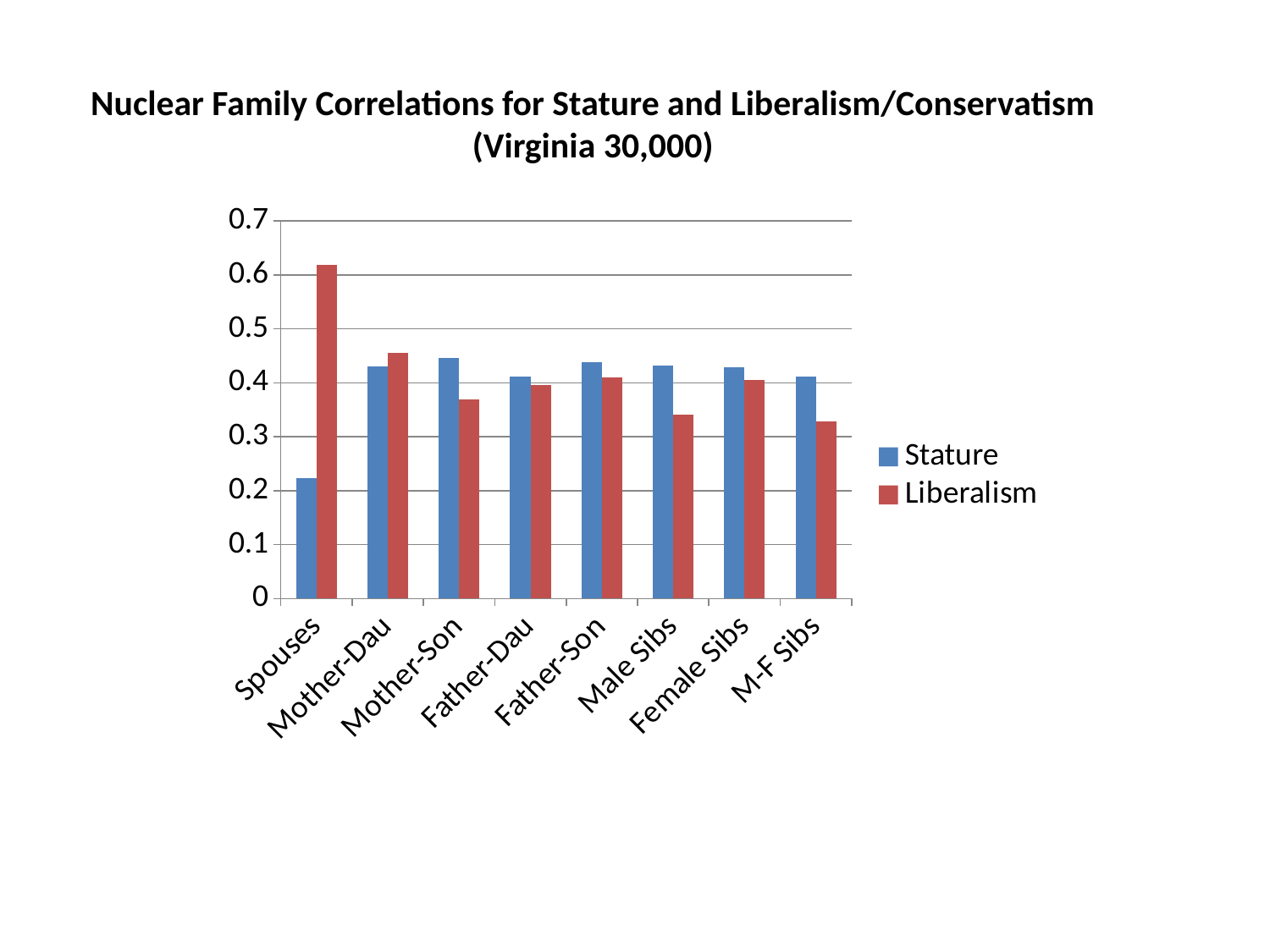
How many series does the legend list? 2 What kind of chart is shown on the slide? bar chart Which category has the lowest Stature correlation? Spouses How many family relationship categories are shown on the x axis? 8 For Male Sibs, which is larger, the Stature or the Liberalism correlation? Stature Which colour represents the Liberalism series in the legend? red Is the Stature value for Spouses greater or less than 0.3? less Which category has the highest Liberalism correlation? Spouses For Spouses, which is larger, the Stature or the Liberalism correlation? Liberalism For Mother-Son, which is larger, the Stature or the Liberalism correlation? Stature Is the Liberalism value for Spouses greater or less than 0.6? greater Is the Liberalism value for Male Sibs greater or less than 0.4? less